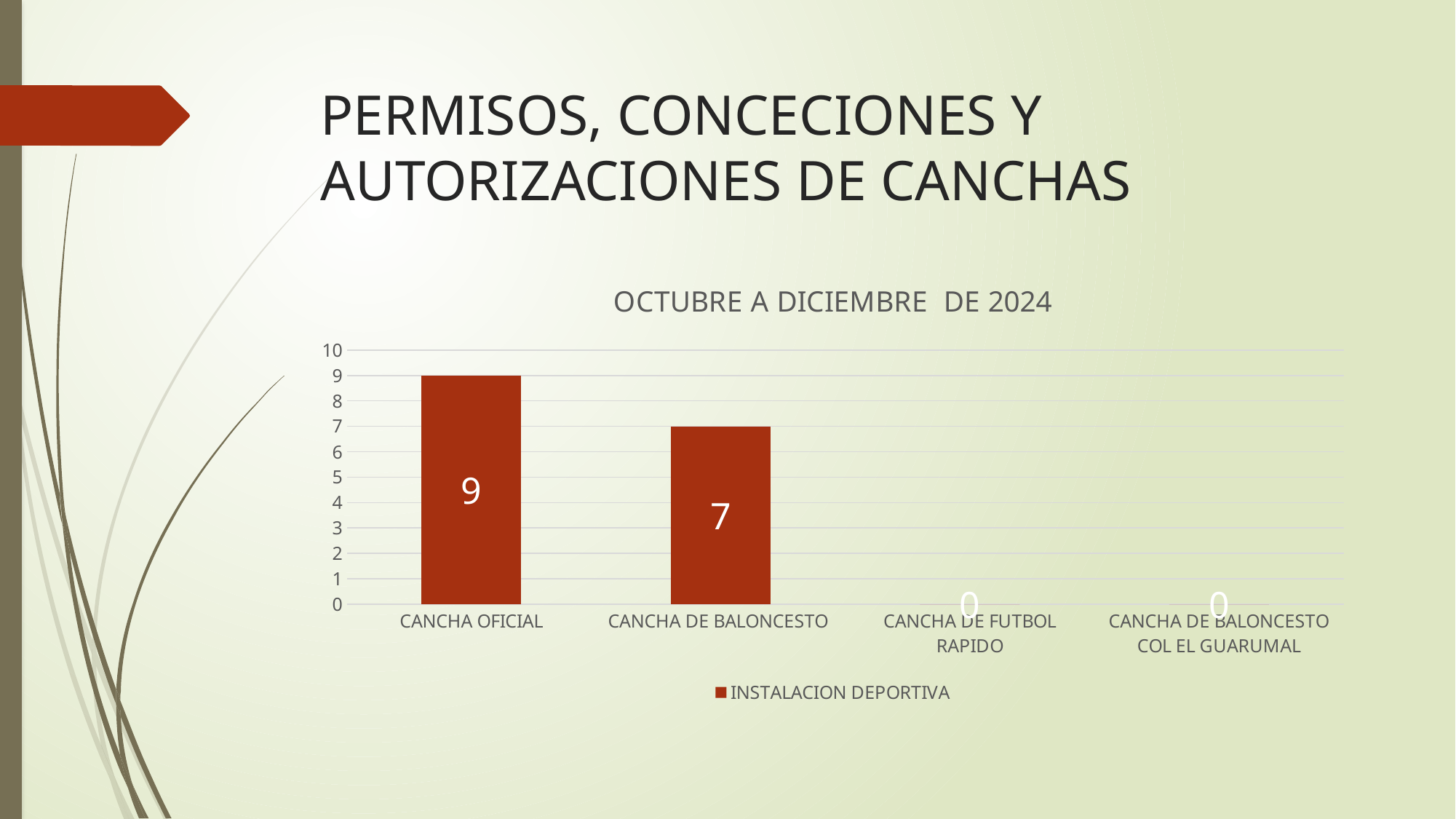
Which is larger, the value for CANCHA OFICIAL or the value for CANCHA DE BALONCESTO? CANCHA OFICIAL What is the value for CANCHA DE FUTBOL RAPIDO? 0 What is the difference between the values for CANCHA OFICIAL and CANCHA DE BALONCESTO? 2 What kind of chart is shown on the slide? bar chart Which category has the highest value? CANCHA OFICIAL How many series does the legend list? 1 What is the value for CANCHA OFICIAL? 9 What is the title of the chart? OCTUBRE A DICIEMBRE DE 2024 What is the value for CANCHA DE BALONCESTO? 7 What is the value for CANCHA DE BALONCESTO COL EL GUARUMAL? 0 How many categories are shown on the x axis? 4 What is the name of the series listed in the legend? INSTALACION DEPORTIVA